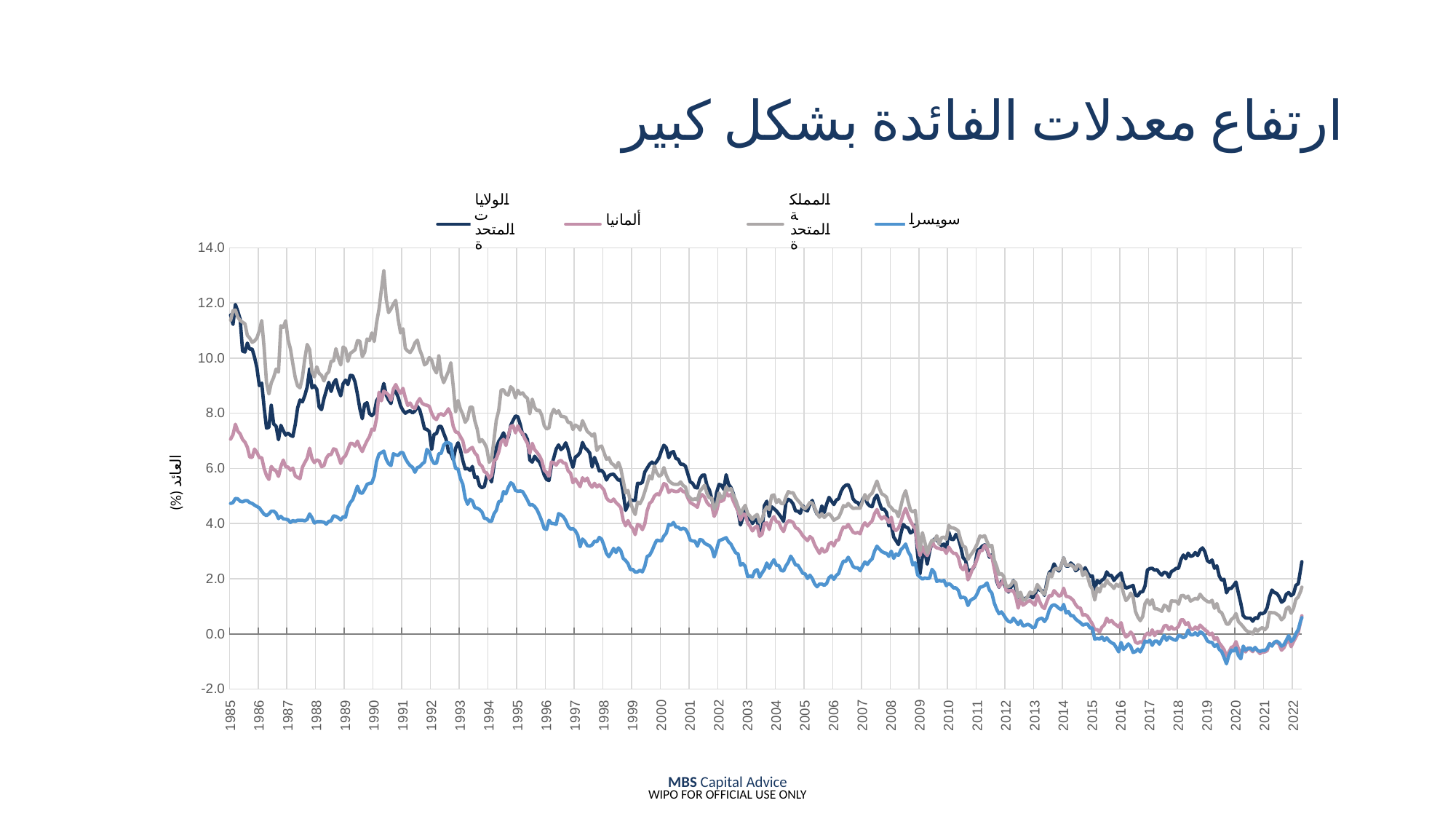
How many series does the legend list? 4 In 2019, which is larger: the value for الولايات المتحدة or the value for سويسرا? الولايات المتحدة What is the title of the chart on the slide? ارتفاع معدلات الفائدة بشكل كبير Overall, do the values rise or fall from 1985 to 2022? fall Is the value for سويسرا in 2016 greater or less than 0.0? less What is the label on the vertical axis? العائد (%) Is the value for ألمانيا in 1985 greater or less than 6.0? greater Which series reaches the highest value anywhere on the chart? المملكة المتحدة Is the value for سويسرا in 1985 greater or less than 6.0? less Which series has the lowest value in 1985? سويسرا What kind of chart is shown on the slide? line chart